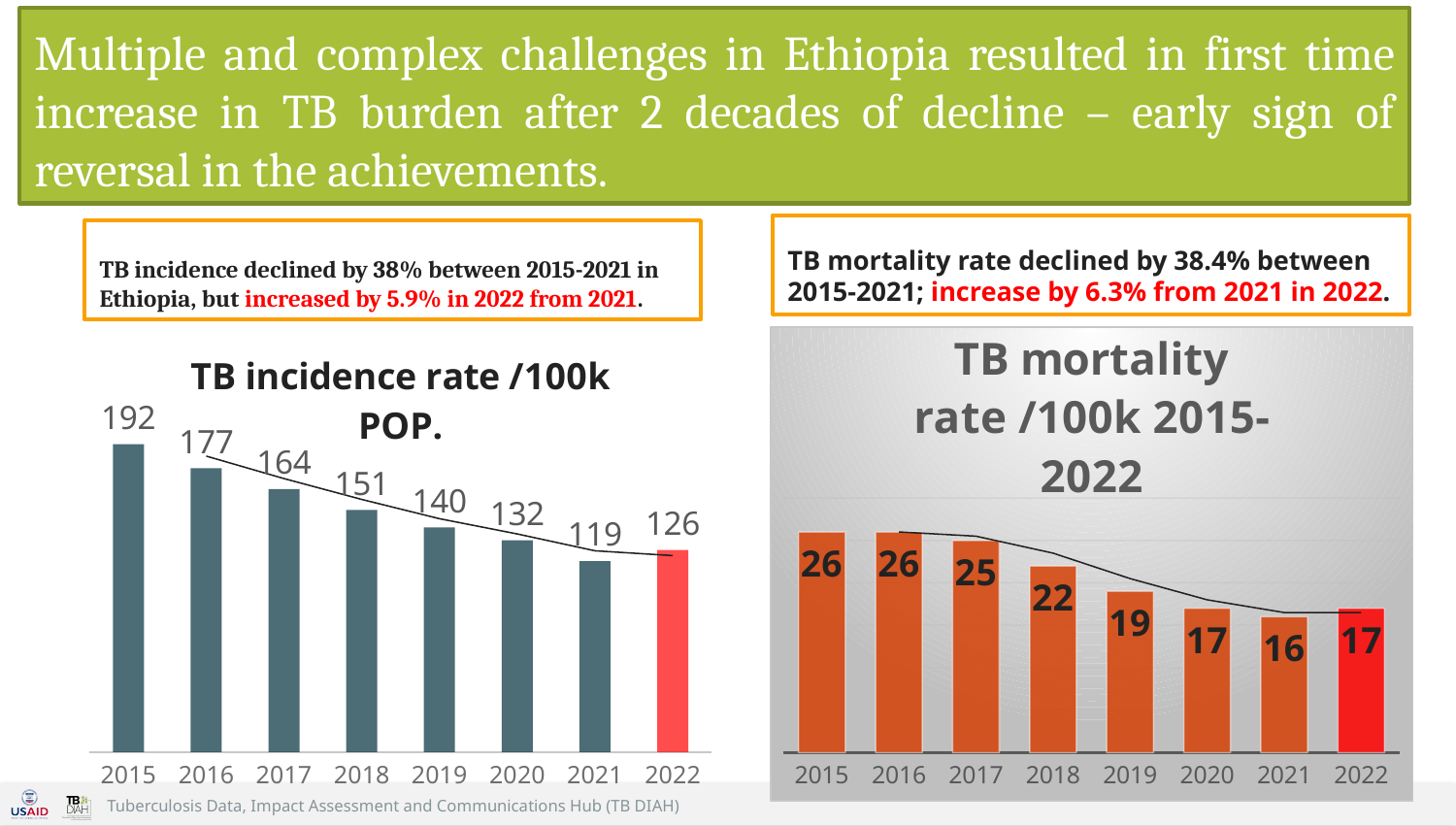
What kind of chart is the 'TB mortality rate /100k 2015-2022' chart? bar chart In the 'TB incidence rate /100k POP.' chart, what is the difference between the 2015 and 2021 values? 73 In the 'TB mortality rate /100k 2015-2022' chart, which year has the lowest value? 2021 In the 'TB incidence rate /100k POP.' chart, what is the value for 2022? 126 In the 'TB incidence rate /100k POP.' chart, which year has the lowest value? 2021 In the 'TB incidence rate /100k POP.' chart, how many years are shown on the x axis? 8 In the 'TB incidence rate /100k POP.' chart, do the values rise or fall from 2015 to 2021? fall In the 'TB mortality rate /100k 2015-2022' chart, what is the difference between the 2015 and 2022 values? 9 In the 'TB mortality rate /100k 2015-2022' chart, what is the value for 2018? 22 In the 'TB mortality rate /100k 2015-2022' chart, which is larger, the value for 2019 or the value for 2020? 2019 In the 'TB incidence rate /100k POP.' chart, what colour is the bar for 2022? red In the 'TB incidence rate /100k POP.' chart, what is the value for 2015? 192